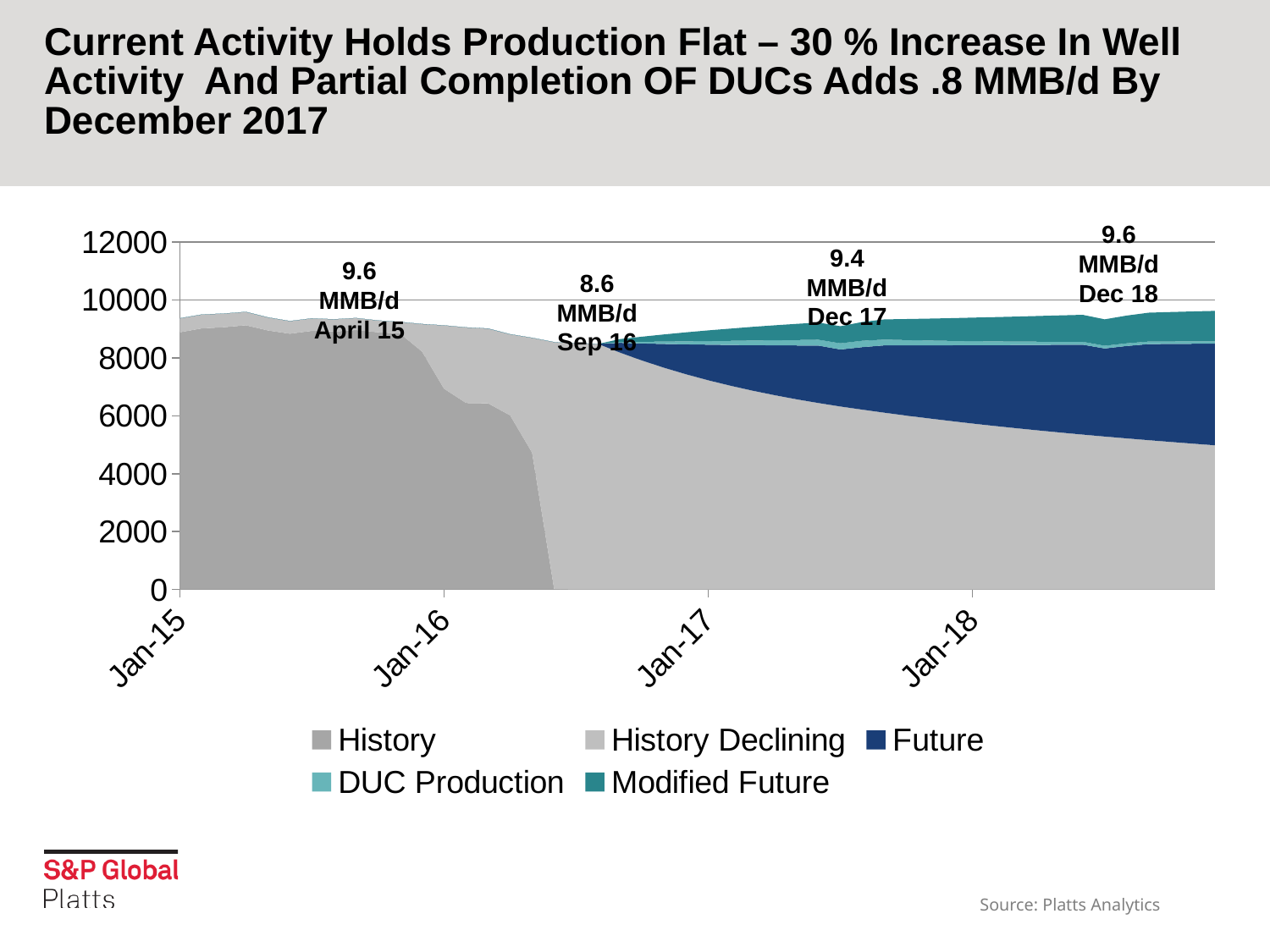
Of the four annotated points, which has the lowest production value? Sep 16 How many series does the legend list? 5 What is the difference between the annotated values for Dec 17 and Sep 16? 0.8 MMB/d What kind of chart is shown on the slide? Area chart What production value is annotated for Sep 16? 8.6 MMB/d What production value is annotated for Dec 18? 9.6 MMB/d Which annotated value is larger, April 15 or Sep 16? April 15 Does the History Declining area rise or fall between Jan-17 and Jan-18? Fall Is the total stacked production at Jan-17 greater or less than 8000? greater What production value is annotated for April 15? 9.6 MMB/d What production value is annotated for Dec 17? 9.4 MMB/d What source is cited for the chart? Platts Analytics